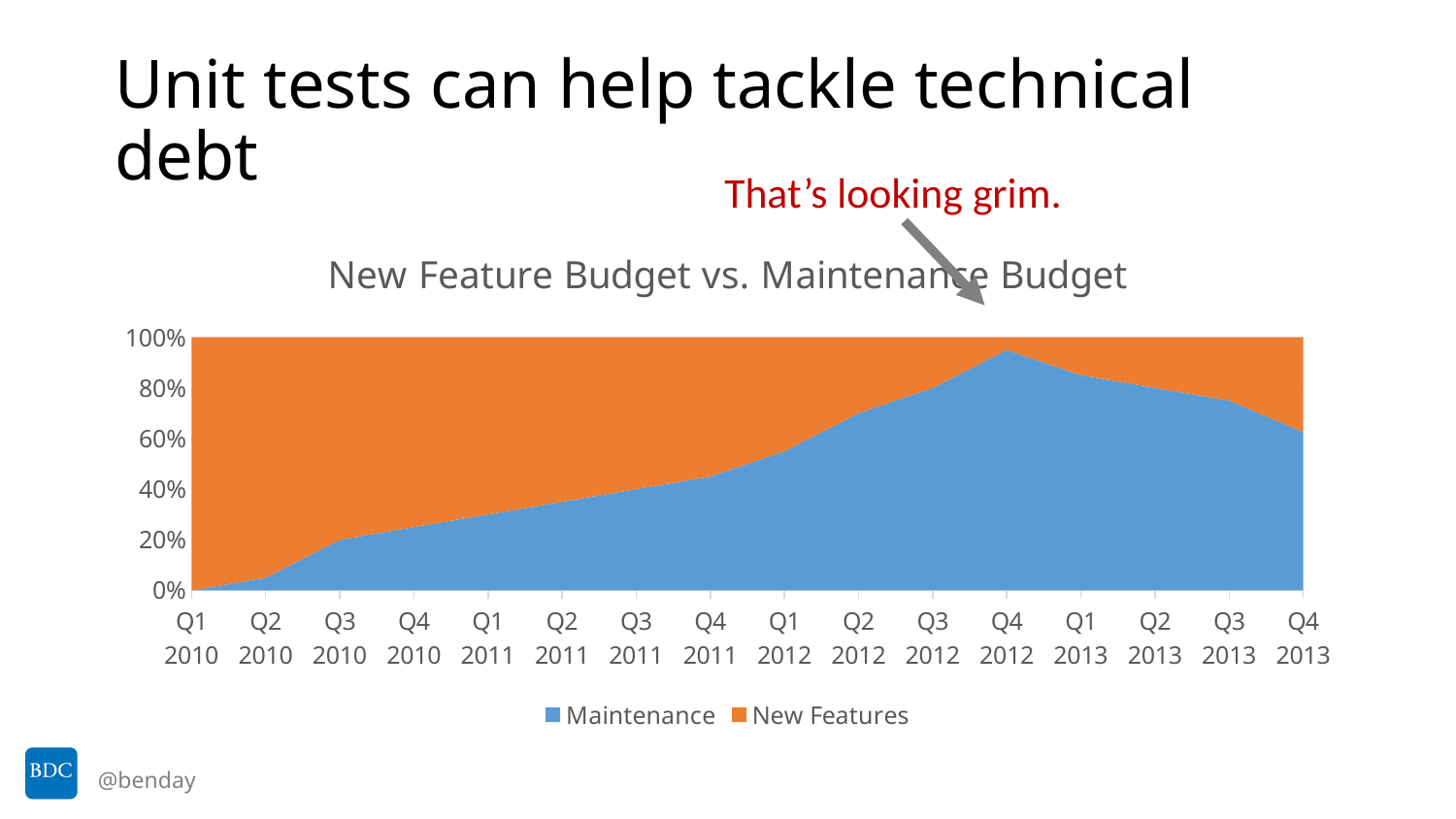
How many quarters are shown along the x axis? 16 How many series does the legend list? 2 In which quarter does the Maintenance share reach its highest point? Q4 2012 Is the Maintenance share in Q4 2012 greater or less than 80%? greater Does the Maintenance share rise or fall from Q1 2010 to Q4 2012? Rise Is the Maintenance share in Q3 2010 greater or less than 40%? less What is the title of the chart? New Feature Budget vs. Maintenance Budget In which quarter is the Maintenance share at its lowest? Q1 2010 Which colour represents the New Features series? Orange Is the Maintenance share in Q2 2012 greater or less than 60%? greater Which is larger in Q1 2011, the Maintenance share or the New Features share? New Features What kind of chart is shown on the slide? Area chart